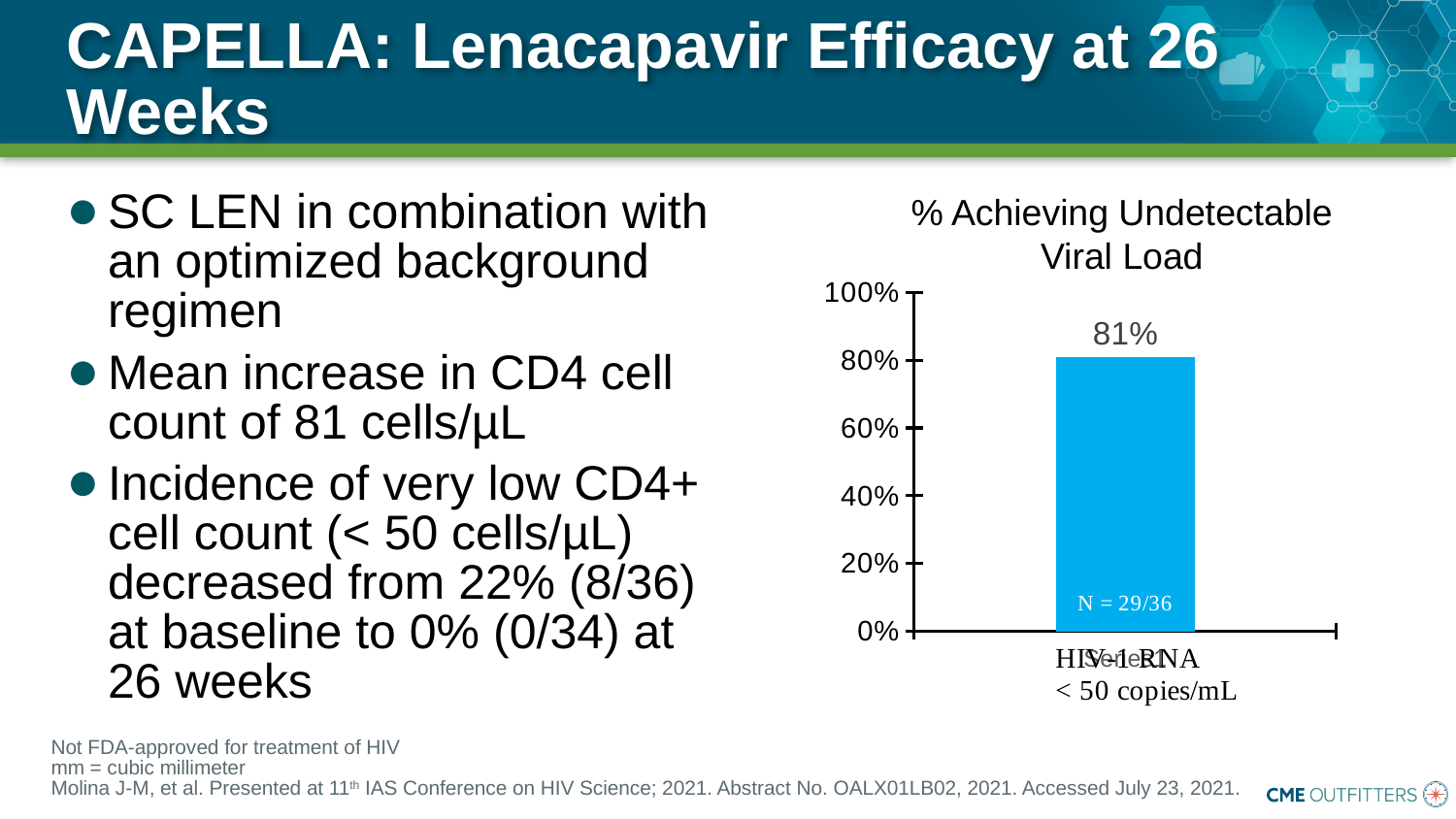
What type of chart is shown on the slide? bar chart Is the value of the bar in the chart greater or less than 80%? greater How many bars are plotted in the chart? 1 What percentage of participants achieved HIV-1 RNA < 50 copies/mL according to the chart? 81% What N value is printed inside the bar of the chart? N = 29/36 What is the maximum value shown on the y-axis of the chart? 100% Is the value of the bar in the chart greater or less than 100%? less What is the difference between the top of the y-axis (100%) and the plotted bar value in the chart? 19% What is the title of the chart on the slide? % Achieving Undetectable Viral Load What value is printed above the bar in the chart? 81%